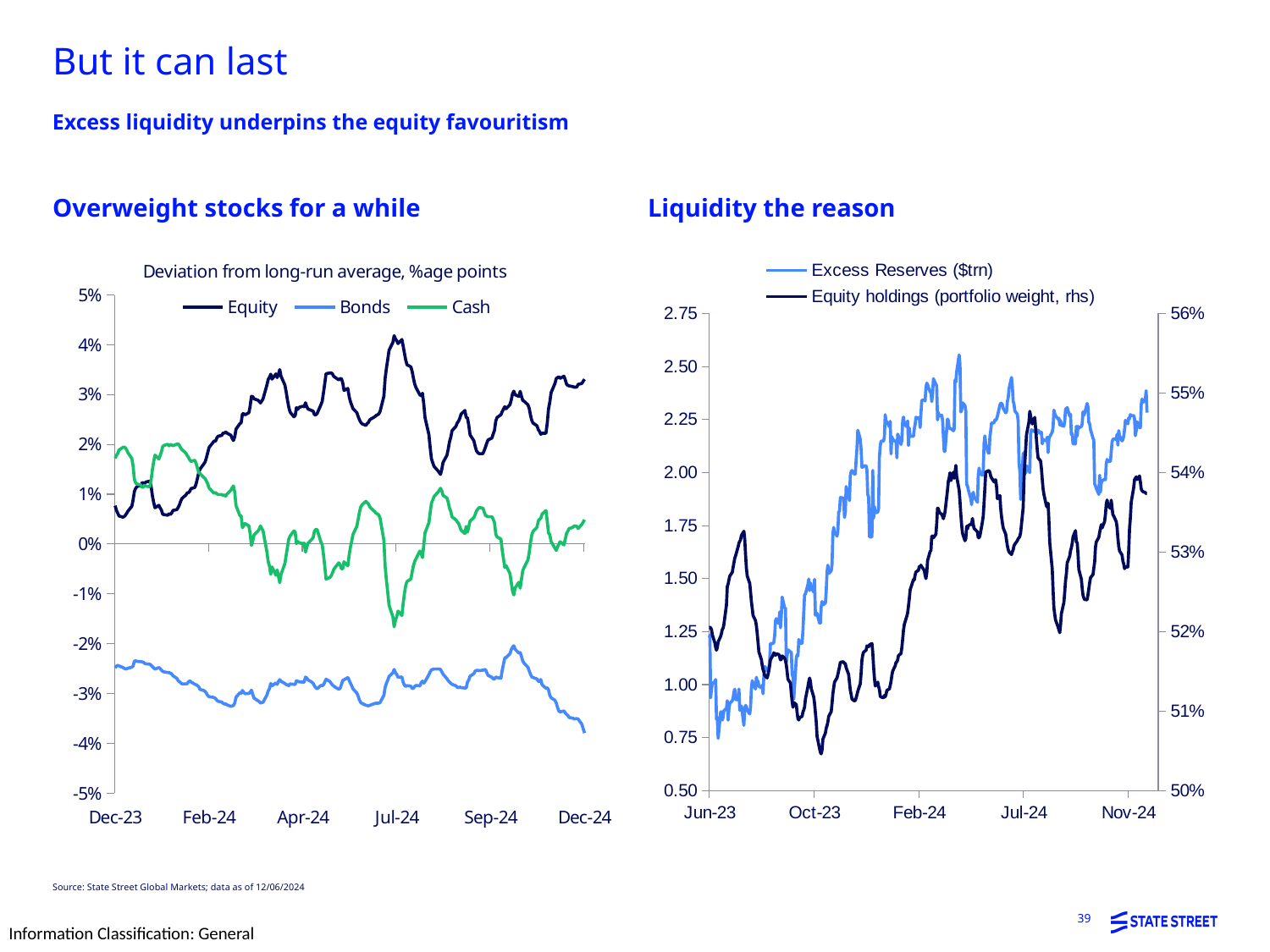
How many series does the legend of the 'Liquidity the reason' chart list? 2 In the 'Overweight stocks for a while' chart, is the Bonds value at Dec-24 greater or less than -3%? less In the 'Overweight stocks for a while' chart, which is larger at Dec-24, Equity or Bonds? Equity What kind of chart is the 'Overweight stocks for a while' chart? line chart In the 'Liquidity the reason' chart, does the Equity holdings line rise or fall between Oct-23 and Feb-24? rise How many series does the legend of the 'Overweight stocks for a while' chart list? 3 In the 'Overweight stocks for a while' chart, is the Cash value at Dec-23 greater or less than 1%? greater In the 'Liquidity the reason' chart, which series is plotted on the right-hand axis? Equity holdings (portfolio weight, rhs) Which series are listed in the legend of the 'Overweight stocks for a while' chart? Equity, Bonds, Cash In the 'Overweight stocks for a while' chart, is the Equity value at Dec-24 greater or less than 3%? greater In the 'Overweight stocks for a while' chart, does the Bonds line rise or fall between Sep-24 and Dec-24? fall